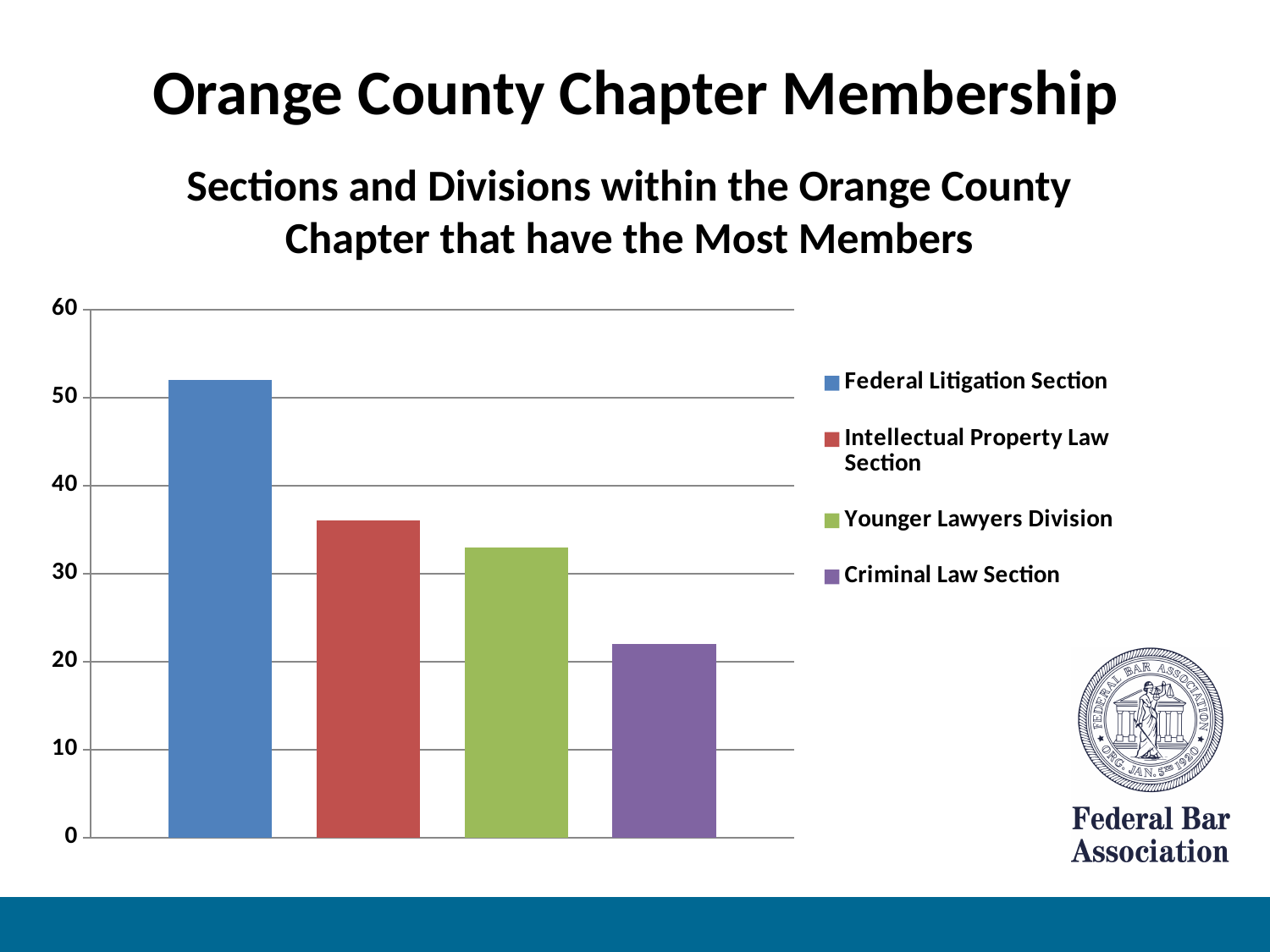
Is the value for Criminal Law Section greater or less than 30? less Which section or division has the fewest members? Criminal Law Section What kind of chart is shown on the slide? bar chart What colour is the bar for Younger Lawyers Division? green Which has more members, Federal Litigation Section or Criminal Law Section? Federal Litigation Section Which section or division has the most members? Federal Litigation Section Is the value for Intellectual Property Law Section greater or less than 30? greater Is the value for Younger Lawyers Division greater or less than 40? less How many bars are plotted in the chart? 4 How many series does the legend list? 4 Which has more members, Intellectual Property Law Section or Criminal Law Section? Intellectual Property Law Section